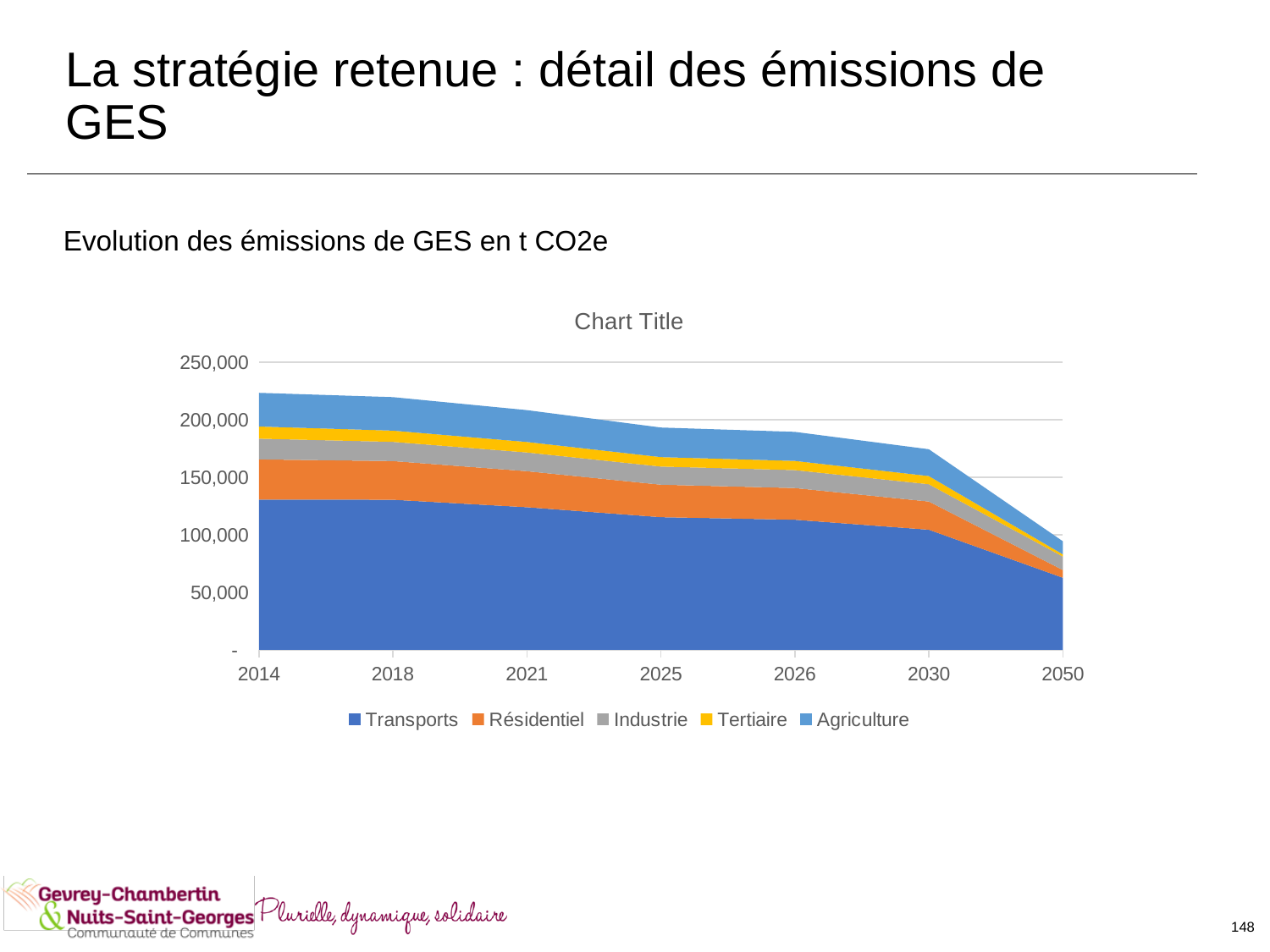
Which series contributes the largest share of emissions in 2014? Transports Is the total value for 2014 greater or less than 200,000? greater Which year has the lowest total emissions? 2050 Which year has the highest total emissions? 2014 Do total emissions rise or fall from 2014 to 2050? Fall Is the value for Transports in 2014 greater or less than 100,000? greater How many years are shown along the x axis? 7 What is the title printed above the chart? Chart Title What kind of chart is shown on the slide? Stacked area chart Is the total value for 2030 greater or less than 200,000? less How many series does the legend list? 5